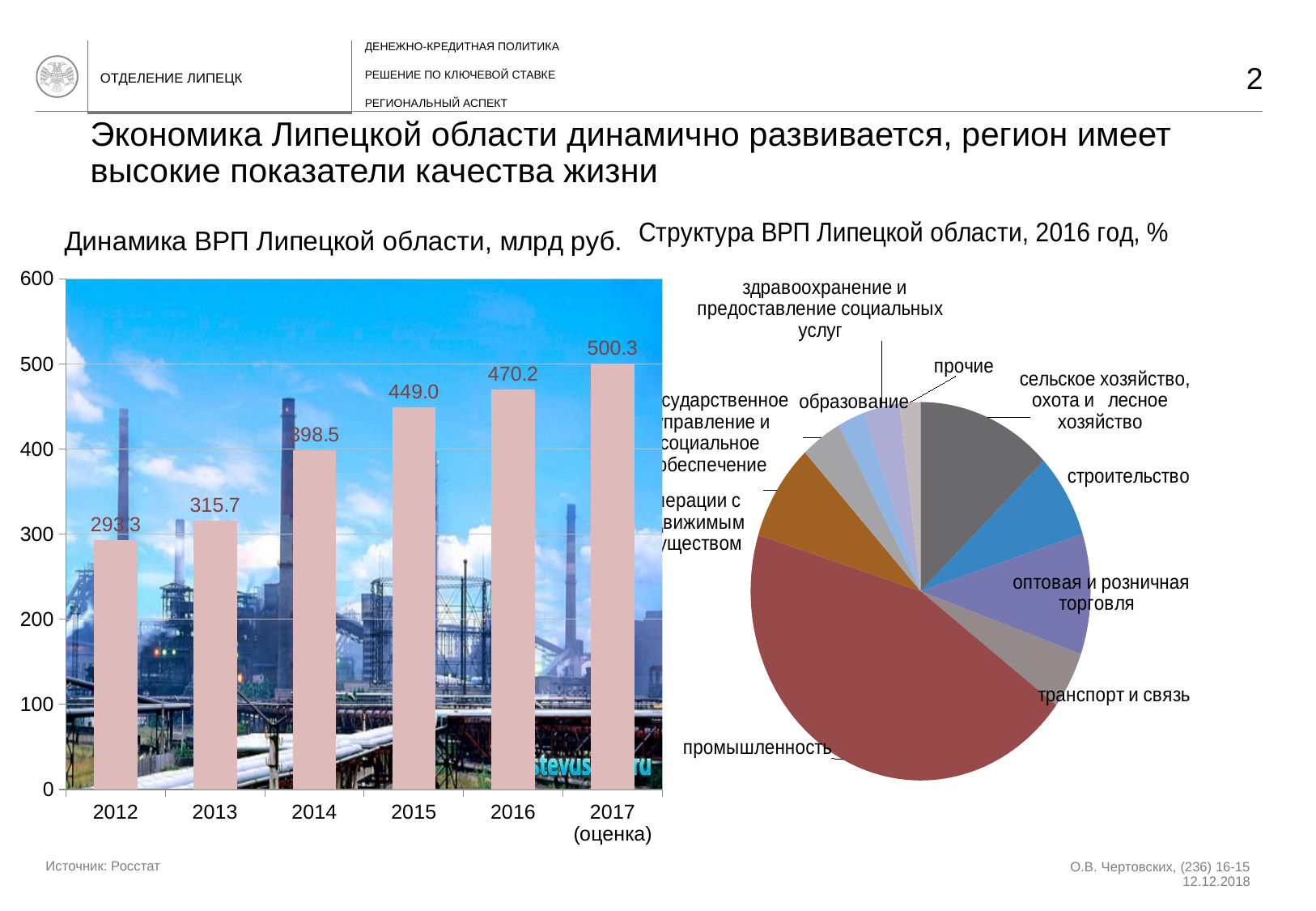
On the chart 'Динамика ВРП Липецкой области, млрд руб.', how many years are shown? 6 What kind of chart is 'Структура ВРП Липецкой области, 2016 год, %'? pie chart On the chart 'Динамика ВРП Липецкой области, млрд руб.', what is the value for 2012? 293.3 On the chart 'Динамика ВРП Липецкой области, млрд руб.', what is the value for 2015? 449.0 On the chart 'Динамика ВРП Липецкой области, млрд руб.', which is larger, the value for 2013 or the value for 2014? 2014 On the chart 'Структура ВРП Липецкой области, 2016 год, %', which sector has the largest slice? промышленность On the chart 'Динамика ВРП Липецкой области, млрд руб.', which year has the highest value? 2017 (оценка) What kind of chart is 'Динамика ВРП Липецкой области, млрд руб.'? bar chart On the chart 'Динамика ВРП Липецкой области, млрд руб.', do the values rise or fall from 2012 to 2017? rise On the chart 'Динамика ВРП Липецкой области, млрд руб.', what is the value for 2017 (оценка)? 500.3 On the chart 'Динамика ВРП Липецкой области, млрд руб.', which year has the lowest value? 2012 On the chart 'Динамика ВРП Липецкой области, млрд руб.', what is the difference between the values for 2016 and 2015? 21.2